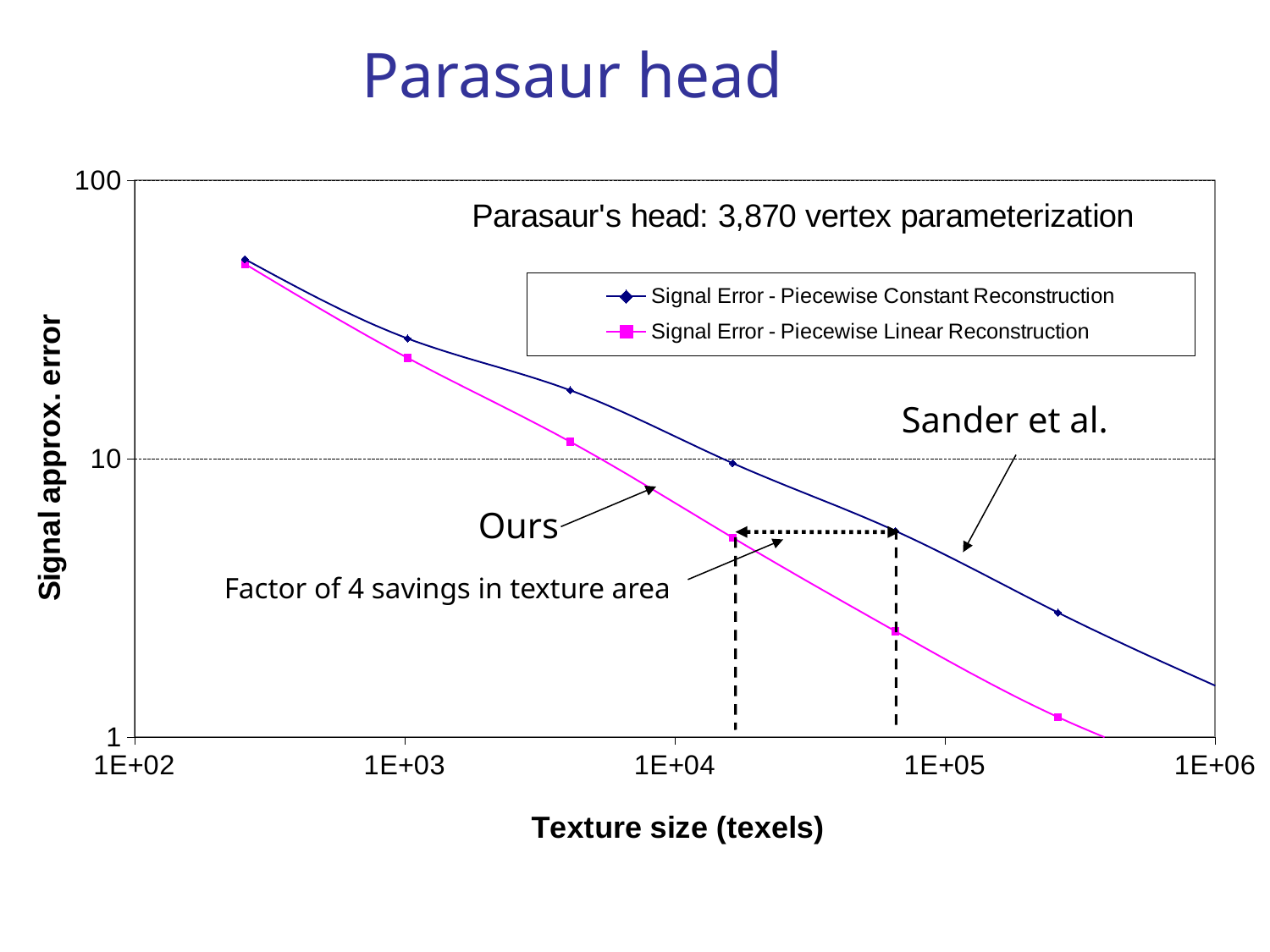
Is the Piecewise Constant Reconstruction error at a texture size of 1E+05 greater or less than 10? less How many series does the legend list? 2 Does the Signal Error - Piecewise Linear Reconstruction series rise or fall as texture size increases? fall At a texture size of 1E+05, which series has the lower signal approximation error: Piecewise Constant Reconstruction or Piecewise Linear Reconstruction? Piecewise Linear Reconstruction At a texture size of 1E+03, which series has the higher signal approximation error: Piecewise Constant Reconstruction or Piecewise Linear Reconstruction? Piecewise Constant Reconstruction Is the Piecewise Constant Reconstruction error at a texture size of 1E+03 greater or less than 10? greater What is the label of the x axis? Texture size (texels) Is the Piecewise Linear Reconstruction error at a texture size of 1E+05 greater or less than 10? less What is the title printed inside the chart area? Parasaur's head: 3,870 vertex parameterization Does the Signal Error - Piecewise Constant Reconstruction series rise or fall as texture size increases? fall What kind of chart is shown on the slide? line chart